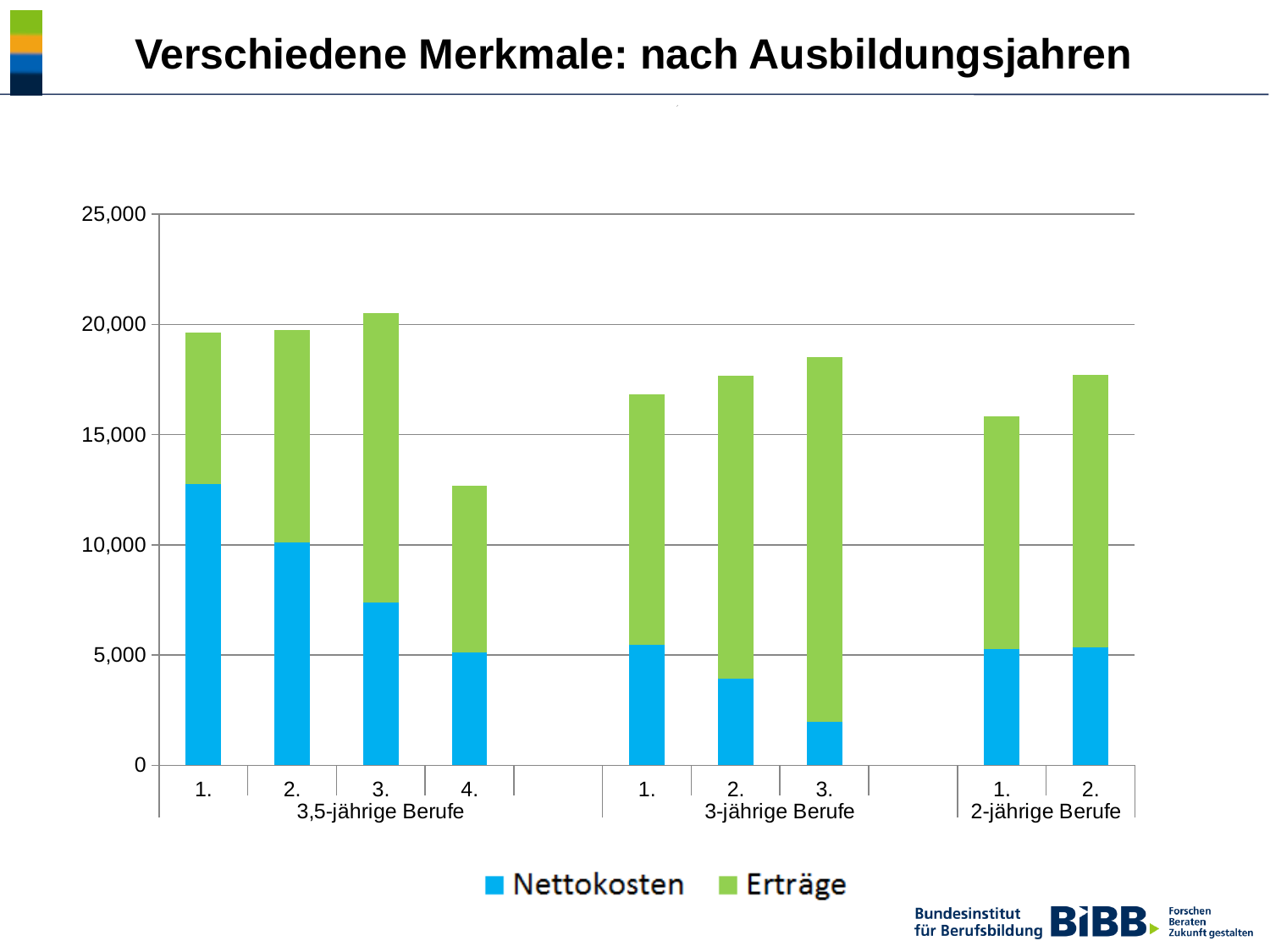
How many training years (bars) are shown for the group '3,5-jährige Berufe'? 4 What are the two series named in the legend? Nettokosten and Erträge How many bars are plotted in the chart in total? 9 What kind of chart is shown on the slide? Stacked bar chart Is the total bar height for the 4. year of 3,5-jährige Berufe greater or less than 15,000? less Is the Nettokosten value for the 1. year of 3,5-jährige Berufe greater or less than 10,000? greater How many series does the legend list? 2 Which bar has the lowest total height? 4. year of 3,5-jährige Berufe Which bar has the largest Nettokosten (blue) segment? 1. year of 3,5-jährige Berufe Within the group '3,5-jährige Berufe', do the Nettokosten values rise or fall from the 1. to the 4. year? fall Which bar has the smallest Nettokosten (blue) segment? 3. year of 3-jährige Berufe Is the Nettokosten value for the 3. year of 3-jährige Berufe greater or less than 5,000? less